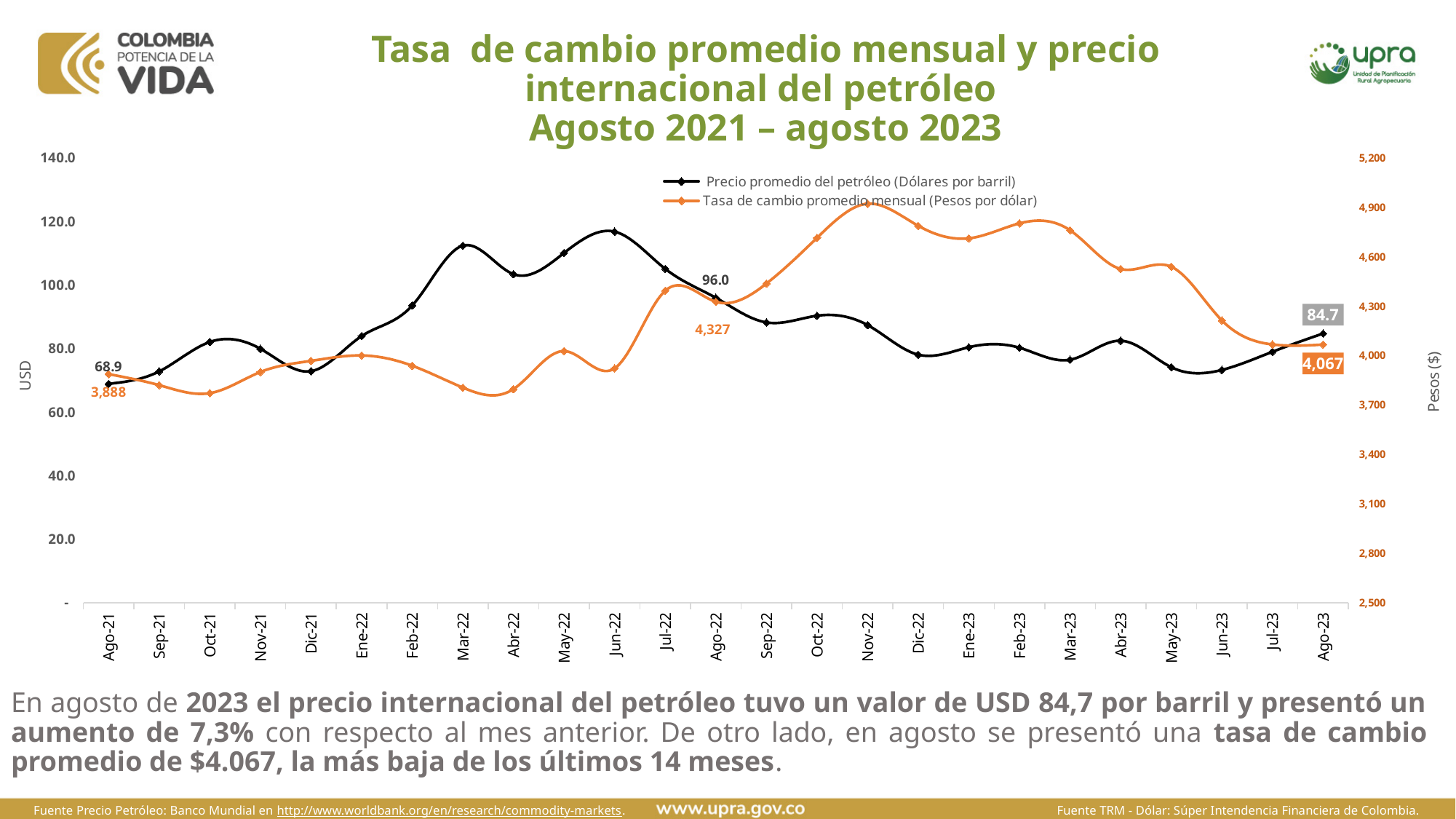
In which month did the average monthly exchange rate reach its highest value? Nov-22 What was the average international oil price (Precio promedio del petróleo) in Ago-21? 68.9 How many series does the legend list? 2 What was the average monthly exchange rate in Ago-23? 4,067 What was the average monthly exchange rate (Tasa de cambio promedio mensual) in Ago-21? 3,888 Is the average oil price for Jun-22 greater or less than 100.0? greater Which month had the higher average oil price, Ago-22 or Ago-23? Ago-22 What was the average monthly exchange rate in Ago-22? 4,327 By how much did the average oil price in Ago-22 exceed the value in Ago-21? 27.1 What kind of chart is shown on the slide? Line chart What was the average international oil price in Ago-23? 84.7 What was the average international oil price in Ago-22? 96.0